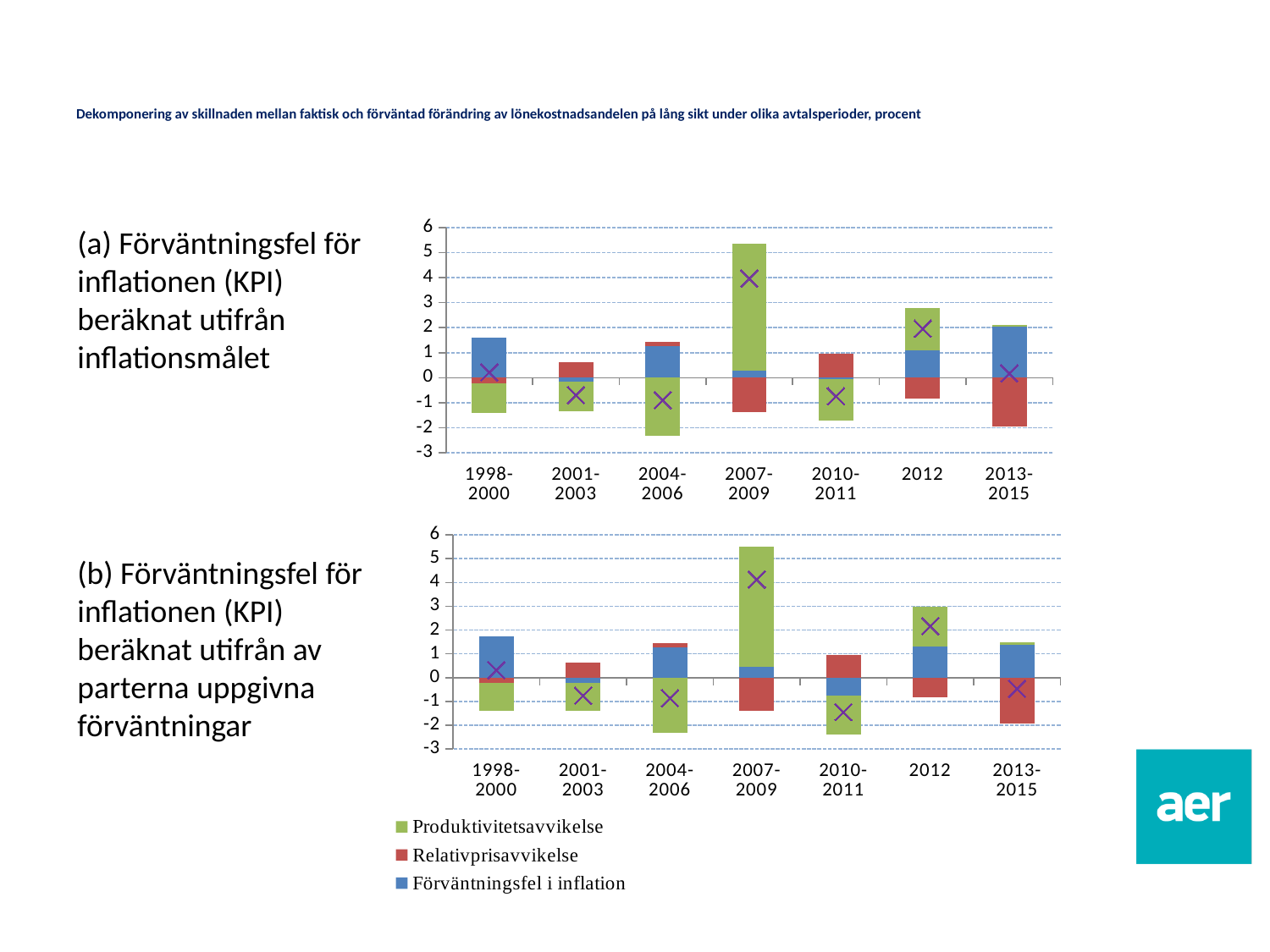
In chart (a), is the X marker for 2012 greater or less than 1? greater In chart (b), which period has the lowest X marker? 2010-2011 In chart (a), is the red Relativprisavvikelse bar for 2013-2015 greater or less than -1? less How many series does the legend below the charts list? 3 In chart (a), which period has the tallest green Produktivitetsavvikelse bar? 2007-2009 In chart (b), which green Produktivitetsavvikelse bar is taller, 2012 or 2013-2015? 2012 Which series is shown in green in the legend? Produktivitetsavvikelse In chart (b), is the green Produktivitetsavvikelse bar for 2007-2009 greater or less than 4? greater What is the third entry in the legend below the charts? Förväntningsfel i inflation How many avtalsperioder (categories) are shown on the x axis of chart (b)? 7 In chart (a), which is higher, the X marker for 2007-2009 or the X marker for 2012? 2007-2009 What kind of chart is chart (a), 'Förväntningsfel för inflationen (KPI) beräknat utifrån inflationsmålet'? Stacked bar chart